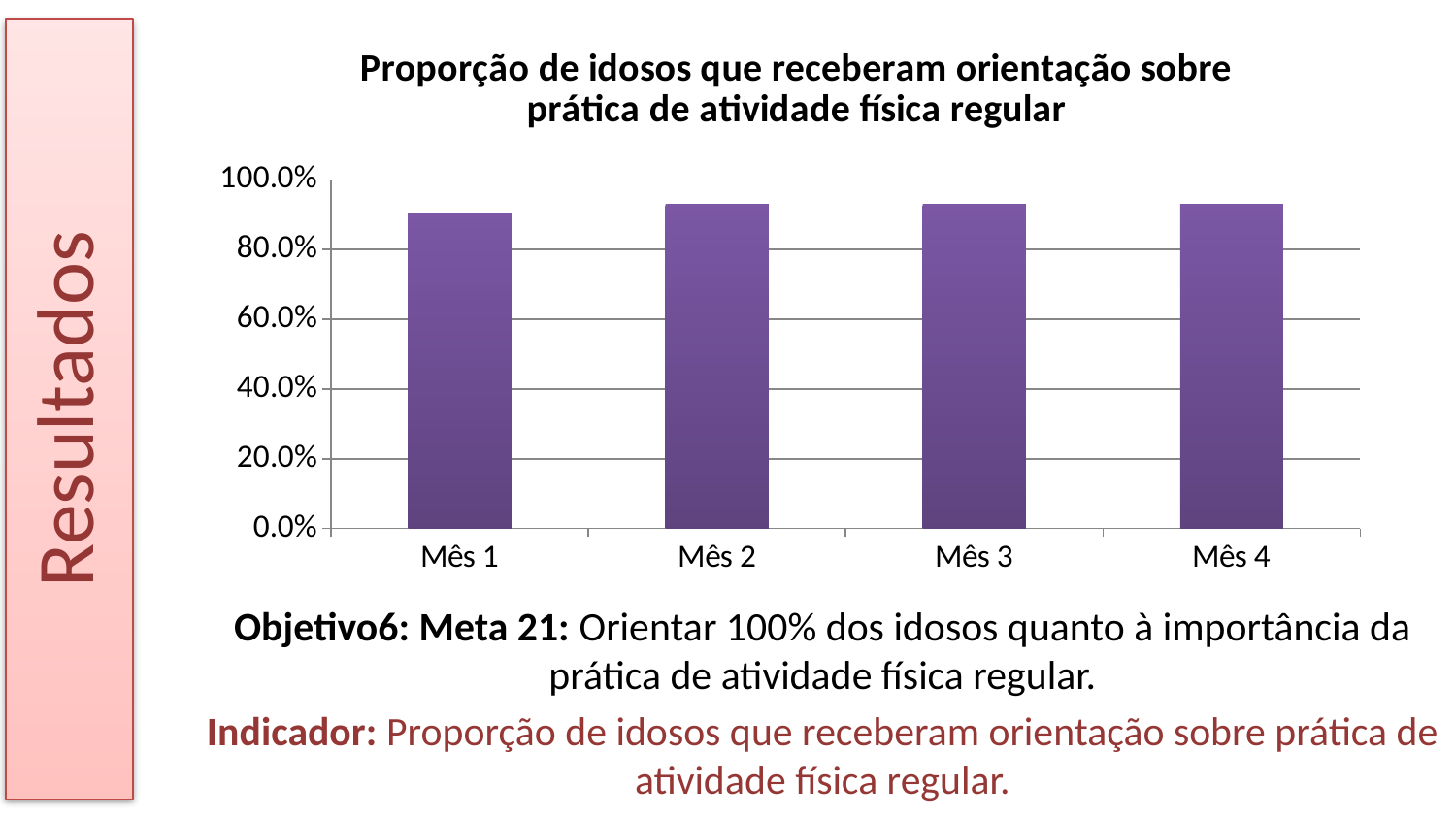
What kind of chart is shown on the slide? bar chart Which month has the lowest value in the chart? Mês 1 Is the value for Mês 1 greater or less than 100.0%? less Is the value for Mês 2 greater or less than 100.0%? less Is the value for Mês 4 greater or less than 60.0%? greater What is the highest value shown on the y axis of the chart? 100.0% What is the label of the first category on the x axis? Mês 1 What is the title of the chart? Proporção de idosos que receberam orientação sobre prática de atividade física regular How many months (categories) are shown on the x axis of the chart? 4